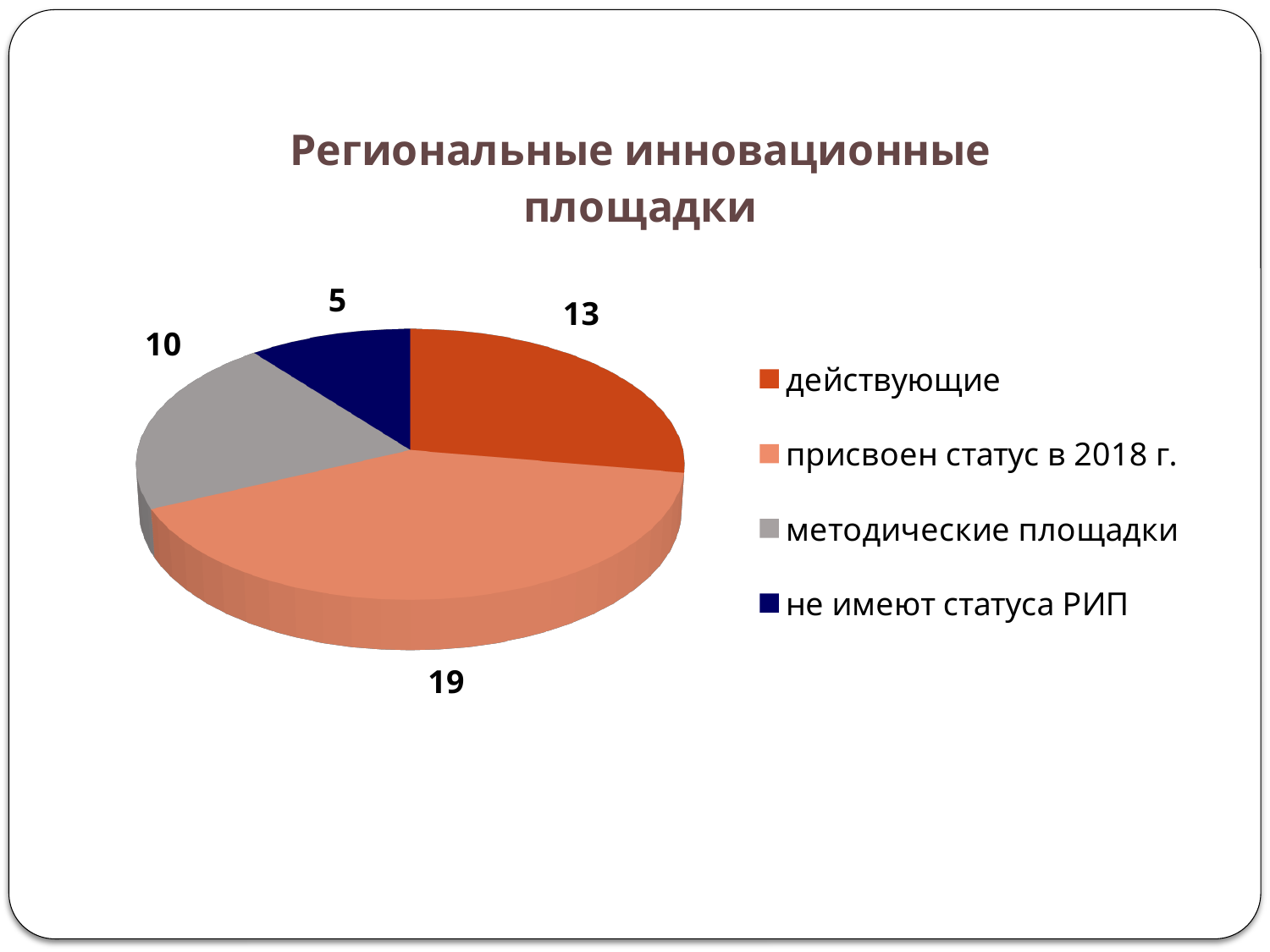
What type of chart is shown on the slide? pie chart Which is larger: "методические площадки" or "не имеют статуса РИП"? методические площадки What is the difference between the values for "присвоен статус в 2018 г." and "действующие"? 6 What is the value for "присвоен статус в 2018 г."? 19 How many categories does the pie chart have? 4 What is the value for "не имеют статуса РИП"? 5 What is the value for "методические площадки"? 10 What is the total of all slices in the pie chart? 47 Which category has the largest slice? присвоен статус в 2018 г. What is the value for "действующие"? 13 Which category has the smallest slice? не имеют статуса РИП What is the title of the chart? Региональные инновационные площадки